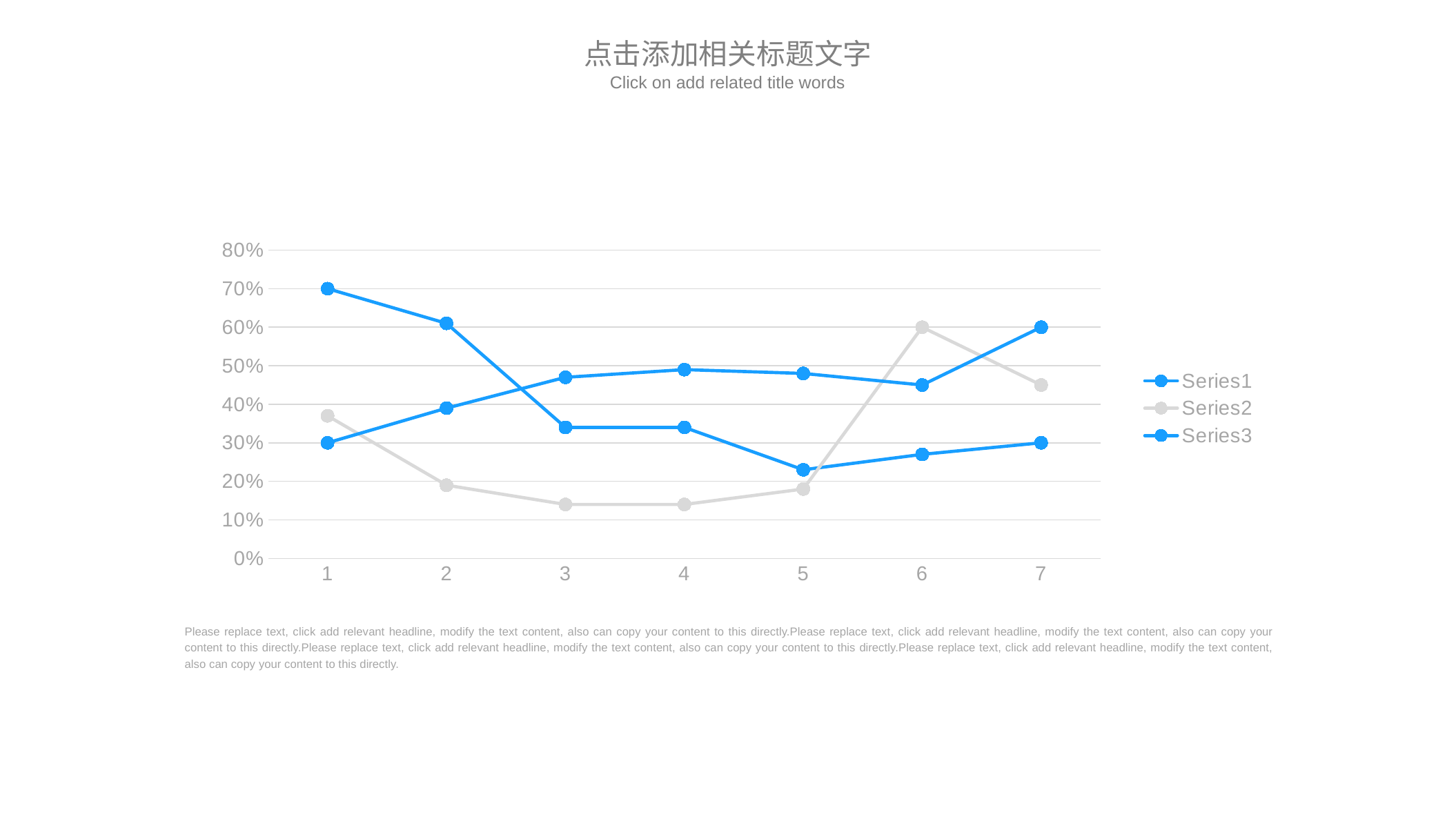
Is the value for Series2 at category 1 greater or less than 30%? greater At which category does Series2 reach its highest value? 6 What is the highest value shown on the y axis? 80% What is the value of Series2 at category 6? 60% How many categories are shown on the x axis? 7 How many series does the legend list? 3 Which series is drawn in grey? Series2 Is the value for Series2 at category 3 greater or less than 20%? less Does Series2 rise or fall from category 1 to category 3? fall Is the value for Series2 at category 4 greater or less than 20%? less What kind of chart is shown on the slide? line chart